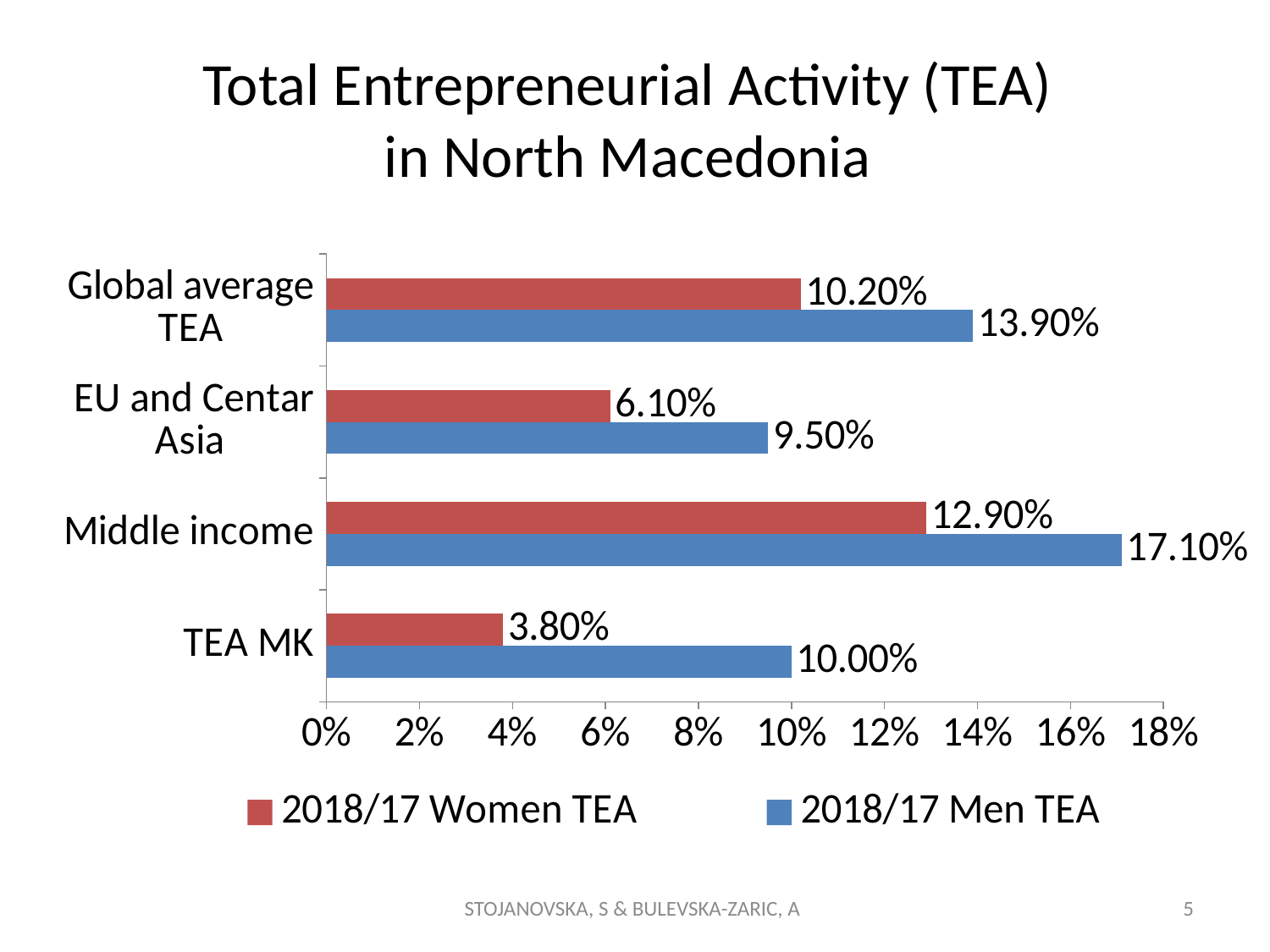
Which category has the lowest 2018/17 Women TEA value? TEA MK What is the 2018/17 Men TEA value for EU and Centar Asia? 9.50% How many series does the legend list? 2 What is the difference between the 2018/17 Men TEA and 2018/17 Women TEA values for TEA MK? 6.20% What colour represents the 2018/17 Men TEA series? Blue What kind of chart is shown on the slide? Bar chart Which is larger for Global average TEA: the 2018/17 Women TEA value or the 2018/17 Men TEA value? 2018/17 Men TEA What is the 2018/17 Women TEA value for TEA MK? 3.80% What is the 2018/17 Men TEA value for Middle income? 17.10% Which category has the highest 2018/17 Men TEA value? Middle income What is the 2018/17 Women TEA value for Global average TEA? 10.20% How many categories are shown on the chart? 4